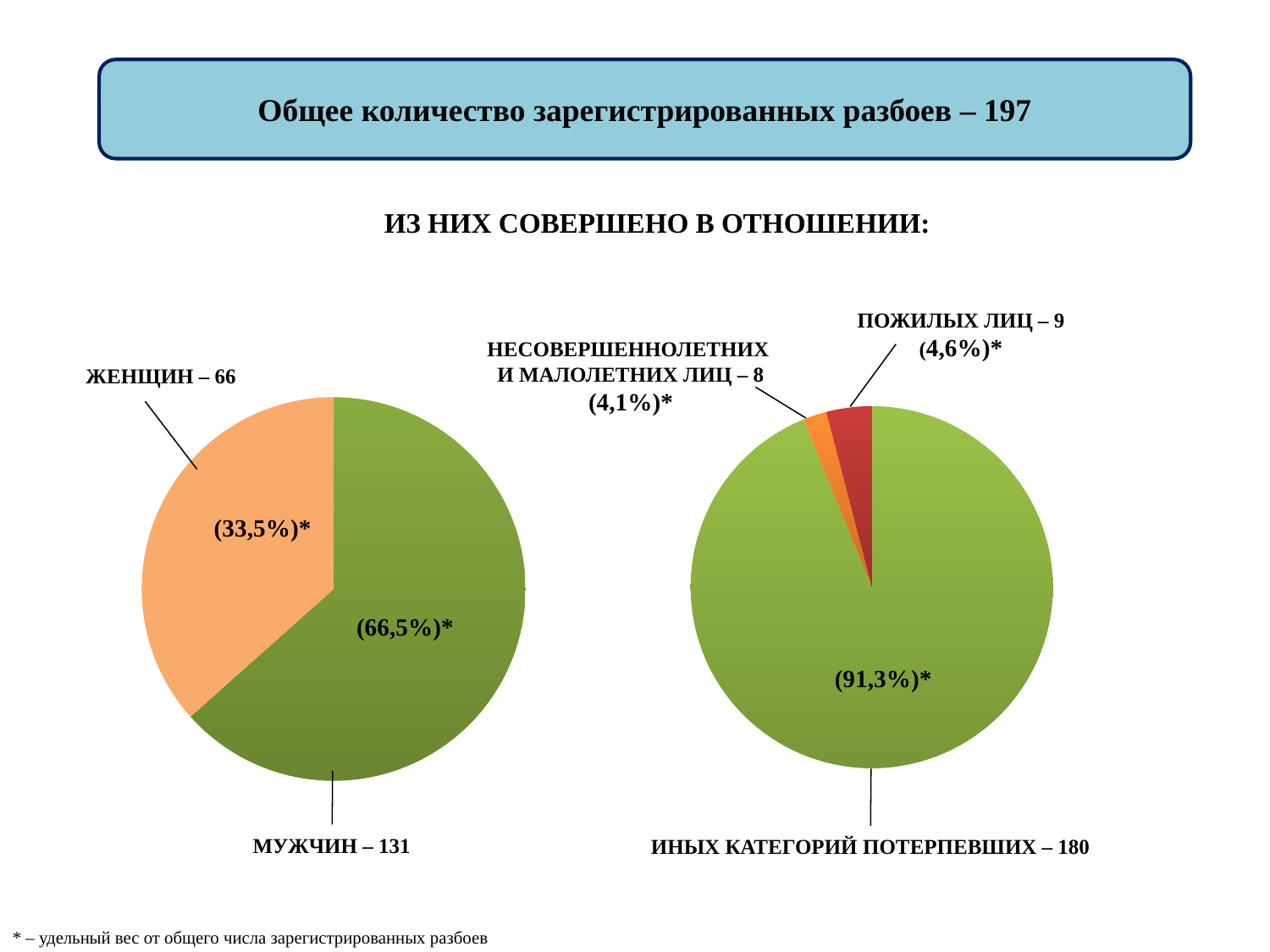
On the left pie chart, how many robberies were committed against women (ЖЕНЩИН)? 66 On the right pie chart, which category has the largest number of robberies? ИНЫХ КАТЕГОРИЙ ПОТЕРПЕВШИХ On the left pie chart, what share of the total do robberies against men (МУЖЧИН) represent? 66,5% On the left pie chart, what share of the total do robberies against women (ЖЕНЩИН) represent? 33,5% On the right pie chart, what share of the total do other categories of victims (ИНЫХ КАТЕГОРИЙ ПОТЕРПЕВШИХ) represent? 91,3% What type of chart is shown on the left of the slide? Pie chart On the right pie chart, how many robberies were committed against minors and juveniles (НЕСОВЕРШЕННОЛЕТНИХ И МАЛОЛЕТНИХ ЛИЦ)? 8 On the left pie chart, what is the difference between the number of robberies against men and against women? 65 How many slices does the right pie chart have? 3 On the left pie chart, how many robberies were committed against men (МУЖЧИН)? 131 On the right pie chart, how many robberies were committed against elderly persons (ПОЖИЛЫХ ЛИЦ)? 9 On the right pie chart, which category has the smallest number of robberies? НЕСОВЕРШЕННОЛЕТНИХ И МАЛОЛЕТНИХ ЛИЦ